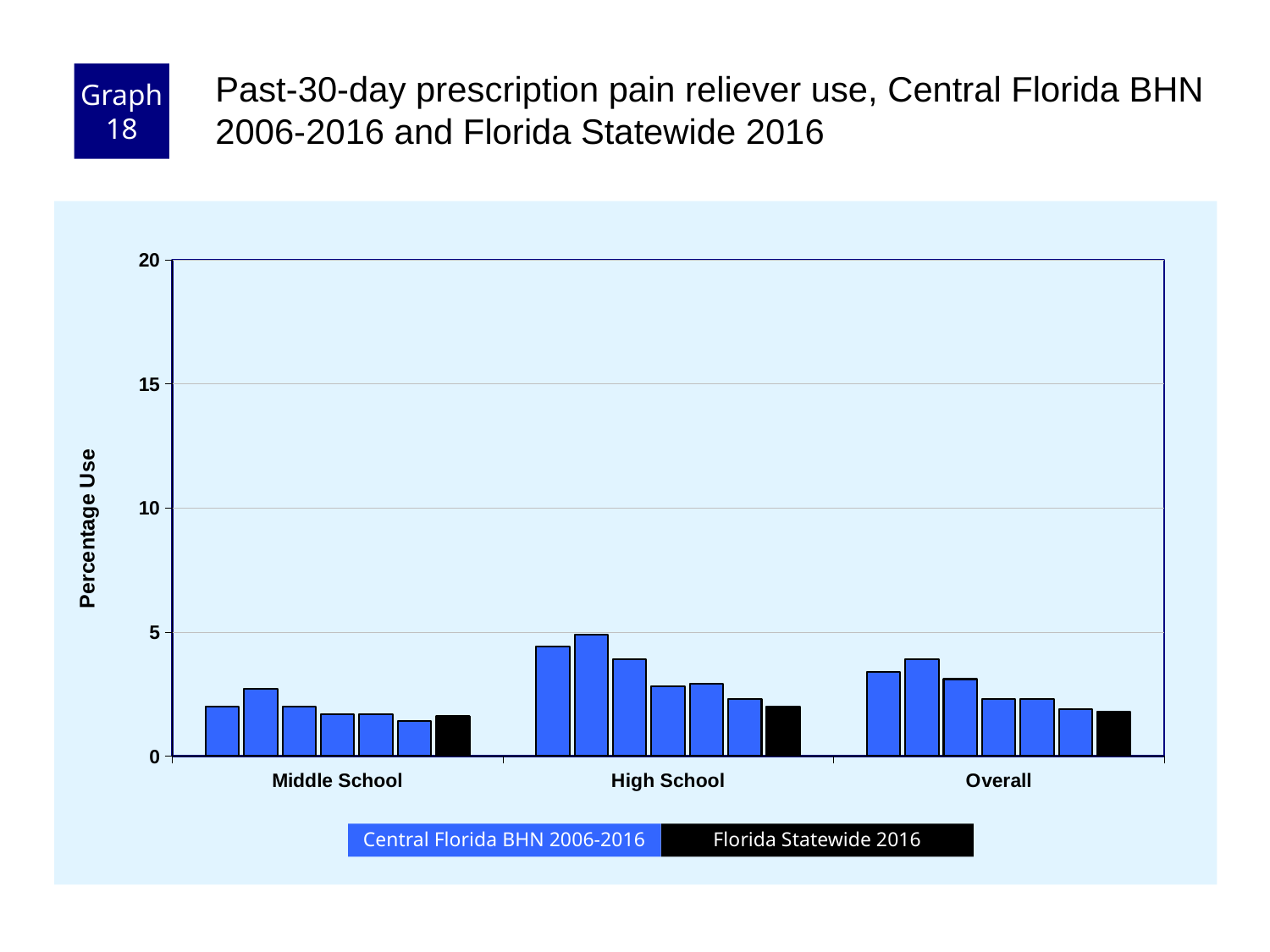
Which series is shown in black in the legend? Florida Statewide 2016 Which is larger: the Florida Statewide 2016 value for High School or for Middle School? High School How many bars are plotted in the High School group? 7 Are any of the bars on the chart greater than 10? No How many series does the legend list? 2 Is the Florida Statewide 2016 value for Middle School greater or less than 5? less How many category groups are shown on the x axis? 3 What is the label on the y axis? Percentage Use What kind of chart is shown on the slide? bar chart Which category group has the lowest bars overall? Middle School Which category group contains the tallest bar? High School